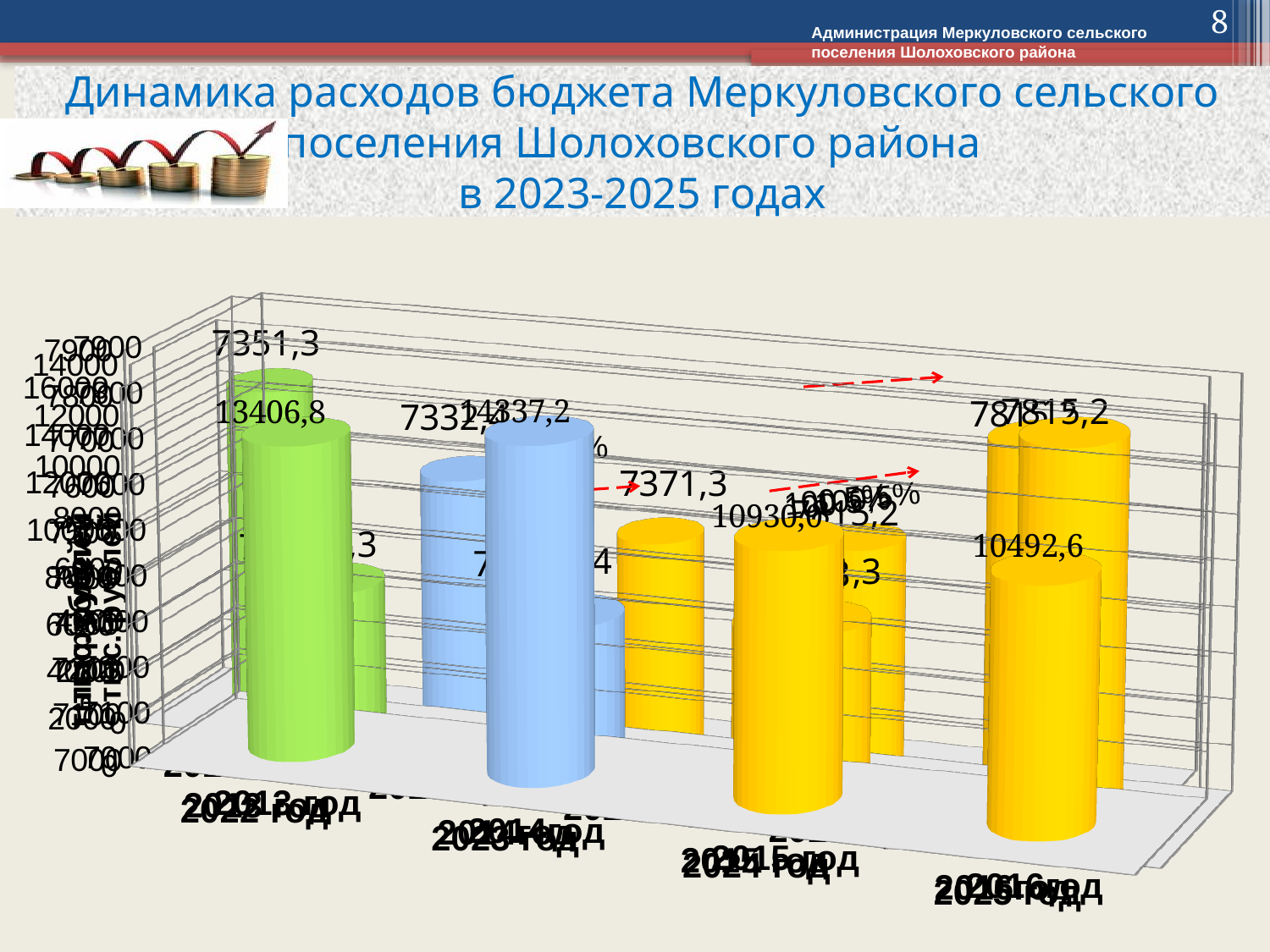
What is the value shown on the large green bar for 2022 год? 13406,8 What is the title of the chart on the slide? Динамика расходов бюджета Меркуловского сельского поселения Шолоховского района в 2023-2025 годах Which is larger, the large bar for 2024 год (10930,0) or the large bar for 2025 год (10492,6)? 2024 год What is the value shown on the large blue bar for 2023 год? 14337,2 What is the value shown on the large yellow bar for 2025 год? 10492,6 Which is larger, the large bar for 2022 год (13406,8) or the large bar for 2023 год (14337,2)? 2023 год What is the difference between the large bar for 2023 год (14337,2) and the large bar for 2022 год (13406,8)? 930,4 What colour is the large bar for 2023 год? blue What kind of chart is shown on the slide? bar chart